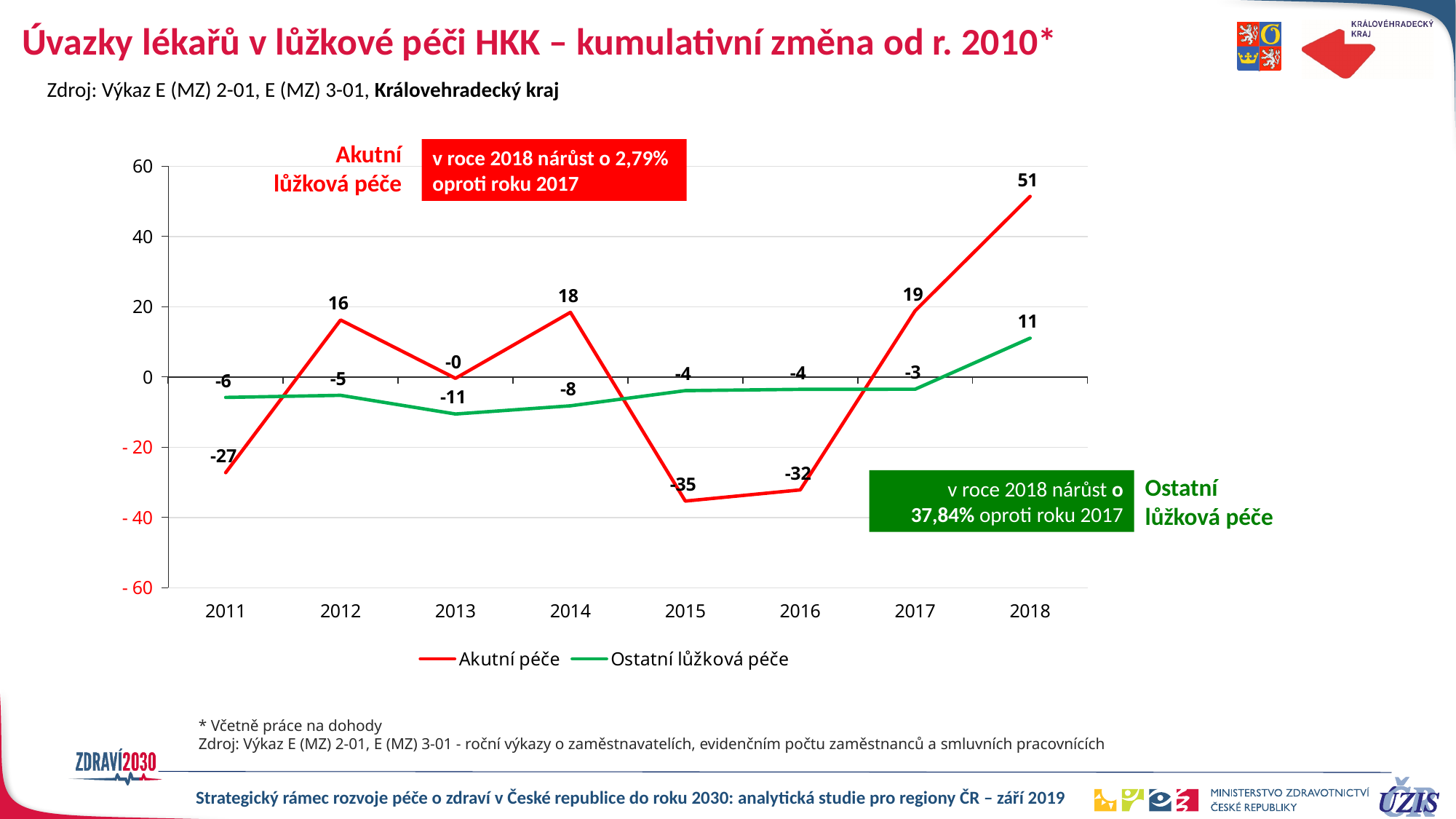
What is the difference between the Akutní péče values in 2018 and 2017? 32 In which year is the Akutní péče value highest? 2018 How many years are shown on the x axis? 8 In which year is the Ostatní lůžková péče value lowest? 2013 Which series has the larger value in 2016, Akutní péče or Ostatní lůžková péče? Ostatní lůžková péče What is the value for Akutní péče in 2018? 51 How many series does the legend list? 2 What type of chart is shown on the slide? line chart Which colour is used for the Akutní péče line? red What is the value for Akutní péče in 2015? -35 What is the value for Ostatní lůžková péče in 2013? -11 In which year is the Akutní péče value lowest? 2015